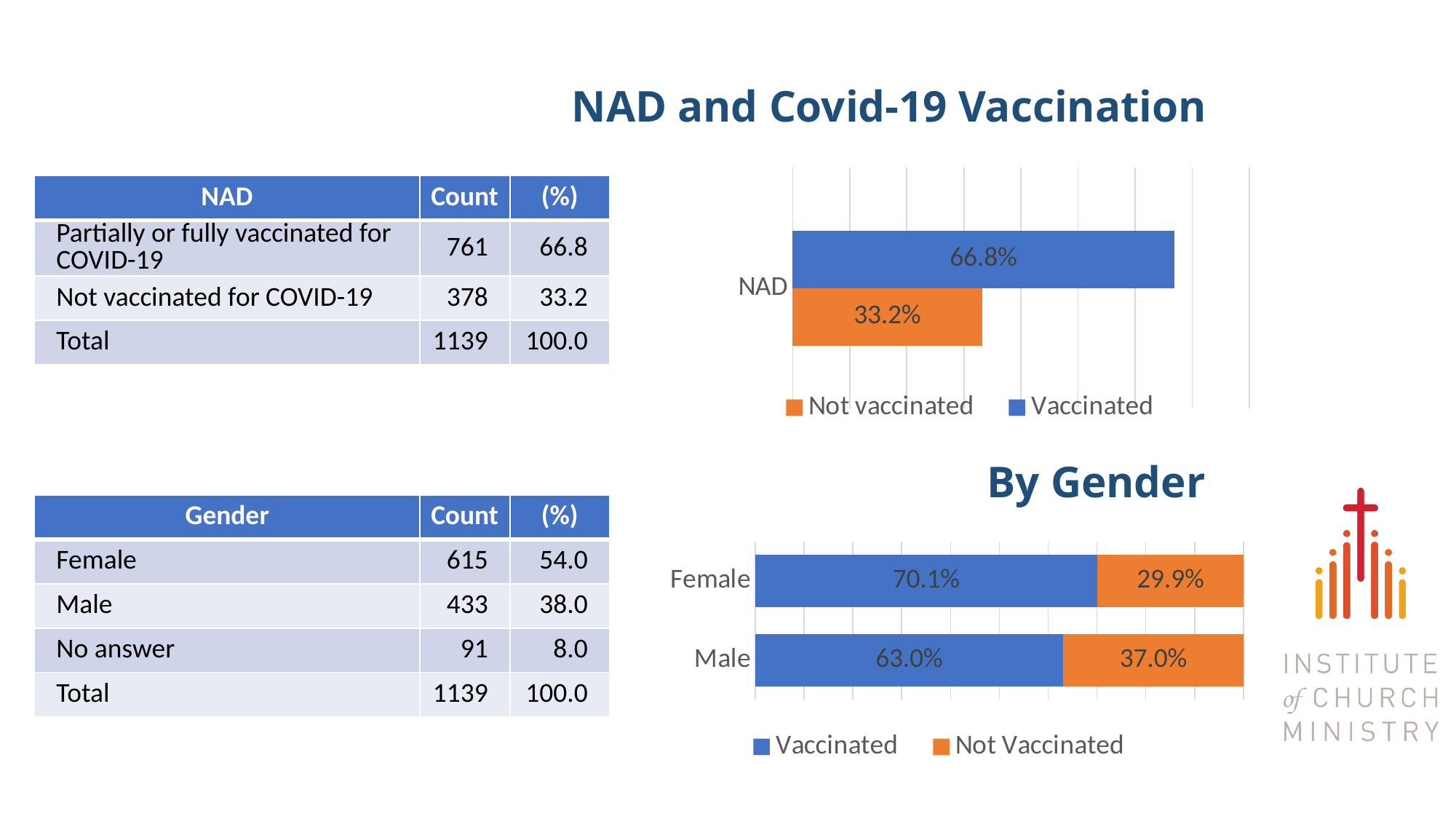
In the top chart (NAD), what is the difference between the Vaccinated and Not vaccinated values? 33.6% In the top chart (NAD), what is the value for Vaccinated? 66.8% In the By Gender chart, what is the Not Vaccinated value for Male? 37.0% In the top chart (NAD), what is the value for Not vaccinated? 33.2% In the By Gender chart, which category has the higher Vaccinated value? Female In the By Gender chart, how many categories are shown? 2 What kind of chart is the By Gender chart? Stacked bar chart In the By Gender chart, what is the Vaccinated value for Female? 70.1% In the top chart (NAD), how many series does the legend list? 2 In the By Gender chart, what is the total of the Male bar? 100.0% In the top chart (NAD), which series is larger, Vaccinated or Not vaccinated? Vaccinated In the By Gender chart, what is the difference between the Vaccinated values for Female and Male? 7.1%